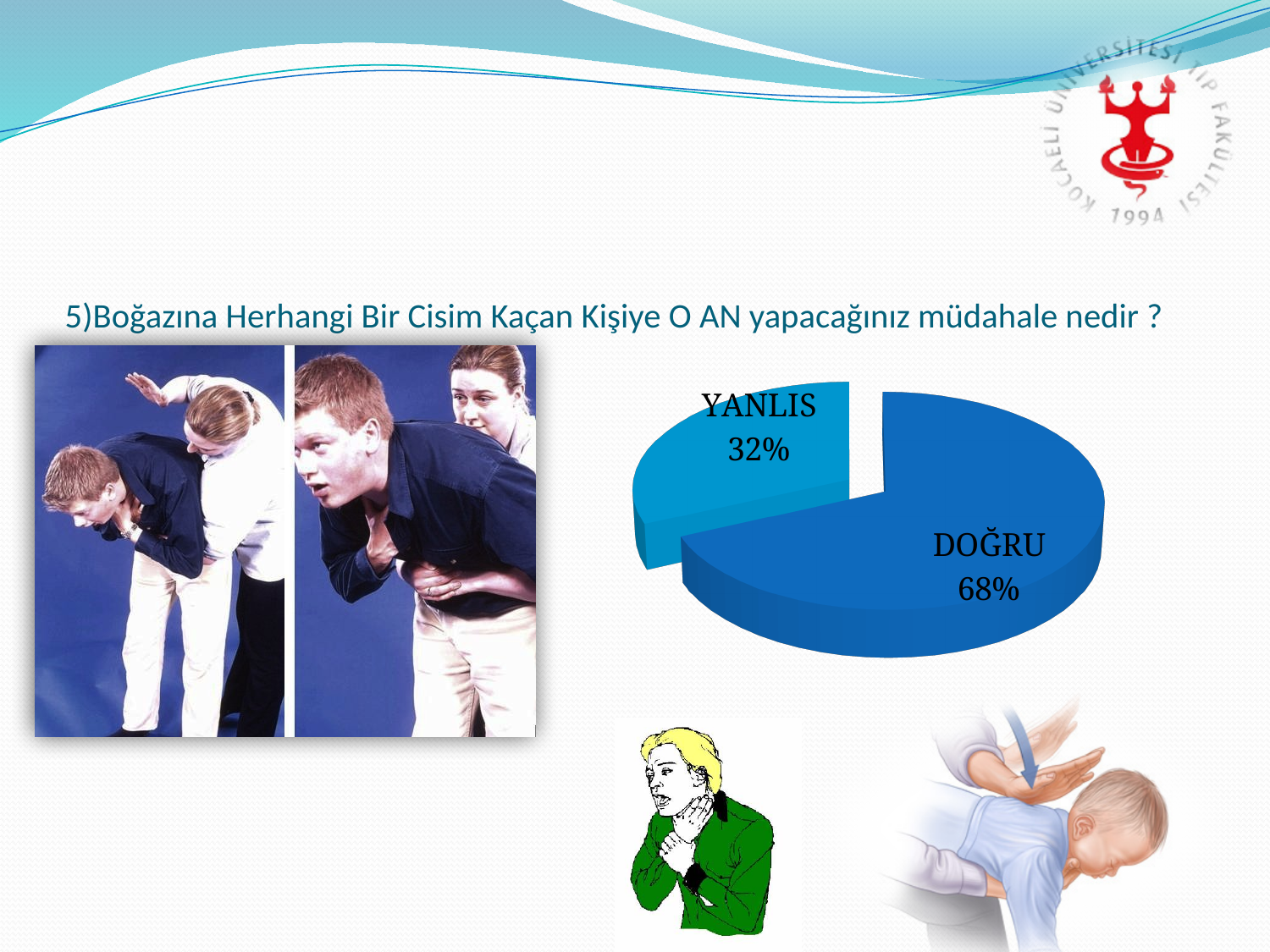
What percentage of the pie chart is labelled DOĞRU? 68% Which slice of the pie chart is the smallest? YANLIS How many slices does the pie chart have? 2 What is the difference in percentage points between the DOĞRU and YANLIS slices? 36 What share of the pie does the YANLIS slice represent? 32% Which slice of the pie chart is the largest? DOĞRU Which is larger in the pie chart, DOĞRU or YANLIS? DOĞRU What percentage of the pie chart is labelled YANLIS? 32% Which slice of the pie chart is pulled out (exploded) from the rest? YANLIS What kind of chart is shown on the slide? pie chart Is the DOĞRU slice greater or less than half of the pie? greater